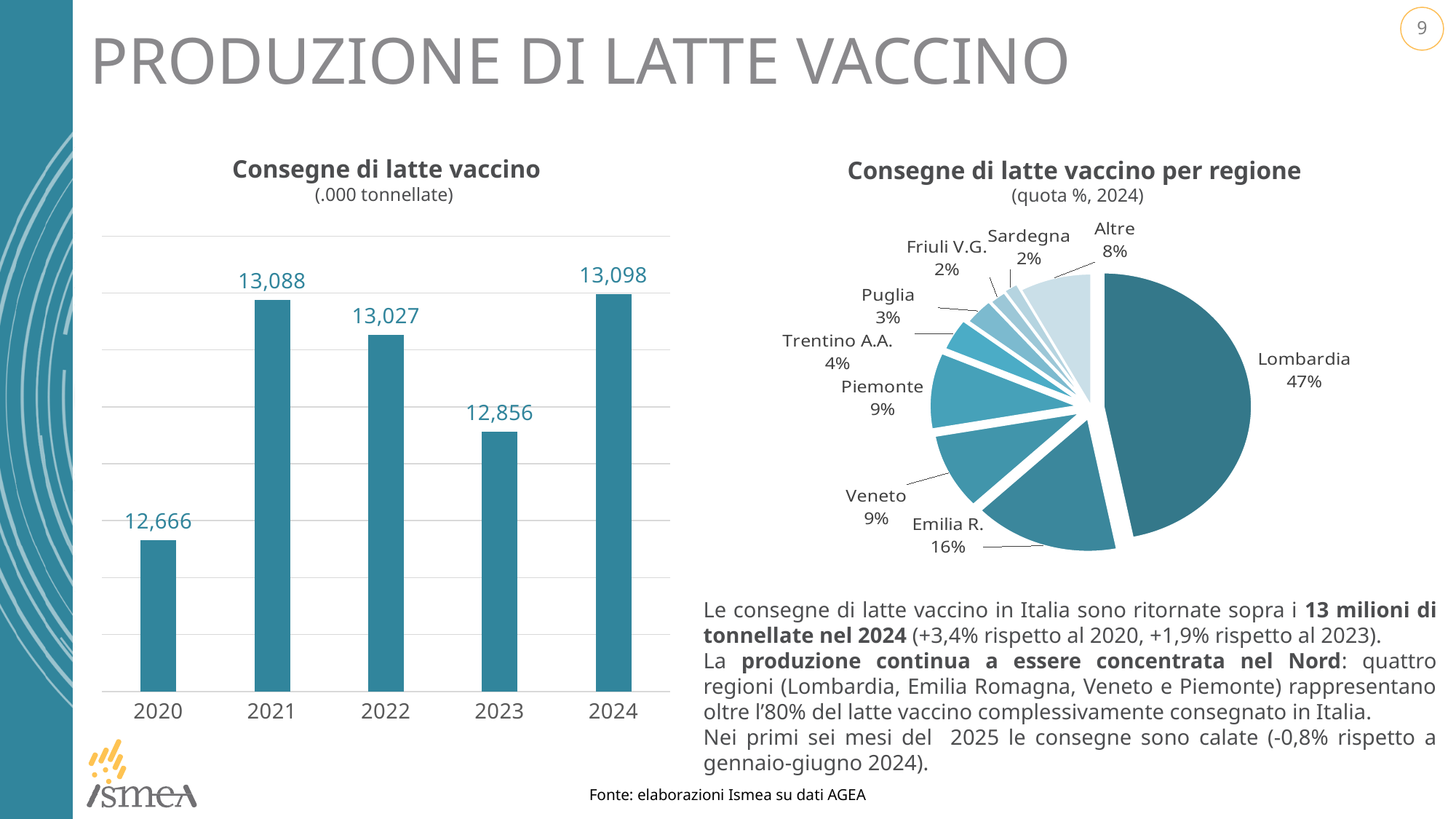
How many years are shown in the 'Consegne di latte vaccino' bar chart? 5 In the 'Consegne di latte vaccino' bar chart, which year has the lowest value? 2020 In the 'Consegne di latte vaccino per regione' pie chart, what is the difference between the shares of Lombardia and Emilia R.? 31% In the 'Consegne di latte vaccino per regione' pie chart, which region has the largest share? Lombardia In the 'Consegne di latte vaccino' bar chart, what is the value for 2022? 13,027 In the 'Consegne di latte vaccino per regione' pie chart, what share does Emilia R. have? 16% What unit is given in the subtitle of the 'Consegne di latte vaccino' bar chart? .000 tonnellate In the 'Consegne di latte vaccino' bar chart, what is the difference between the 2024 value and the 2023 value? 242 In the 'Consegne di latte vaccino' bar chart, which is larger, the value for 2021 or the value for 2022? 2021 How many slices does the 'Consegne di latte vaccino per regione' pie chart have? 9 What kind of chart is 'Consegne di latte vaccino'? Bar chart In the 'Consegne di latte vaccino' bar chart, which year has the highest value? 2024